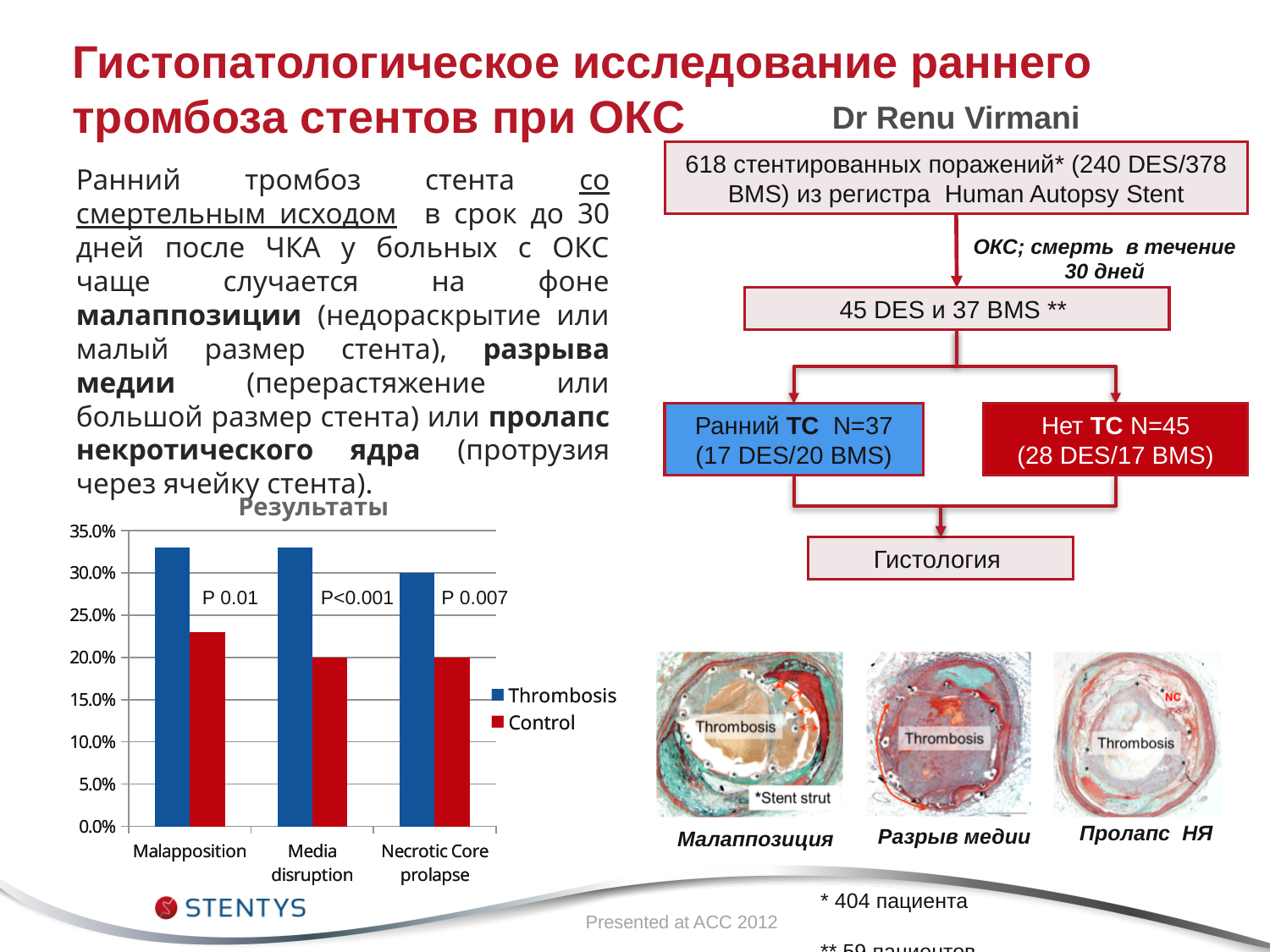
How many categories are shown on the x axis of the "Результаты" chart? 3 In the "Результаты" chart, which category has the highest Control value? Malapposition How many series does the legend of the "Результаты" chart list? 2 What kind of chart is shown under the heading "Результаты"? bar chart In the "Результаты" chart, is the Thrombosis value for Malapposition greater or less than 30.0%? greater In the "Результаты" chart, which series has the larger value for Necrotic Core prolapse, Thrombosis or Control? Thrombosis In the "Результаты" chart, which category has the lowest Thrombosis value? Necrotic Core prolapse In the "Результаты" chart, is the Control value for Media disruption greater or less than 25.0%? less What colour are the Thrombosis bars in the "Результаты" chart? blue In the "Результаты" chart, which series has the larger value for Malapposition, Thrombosis or Control? Thrombosis What are the two legend entries of the "Результаты" chart? Thrombosis and Control In the "Результаты" chart, is the Control value for Malapposition greater or less than 25.0%? less